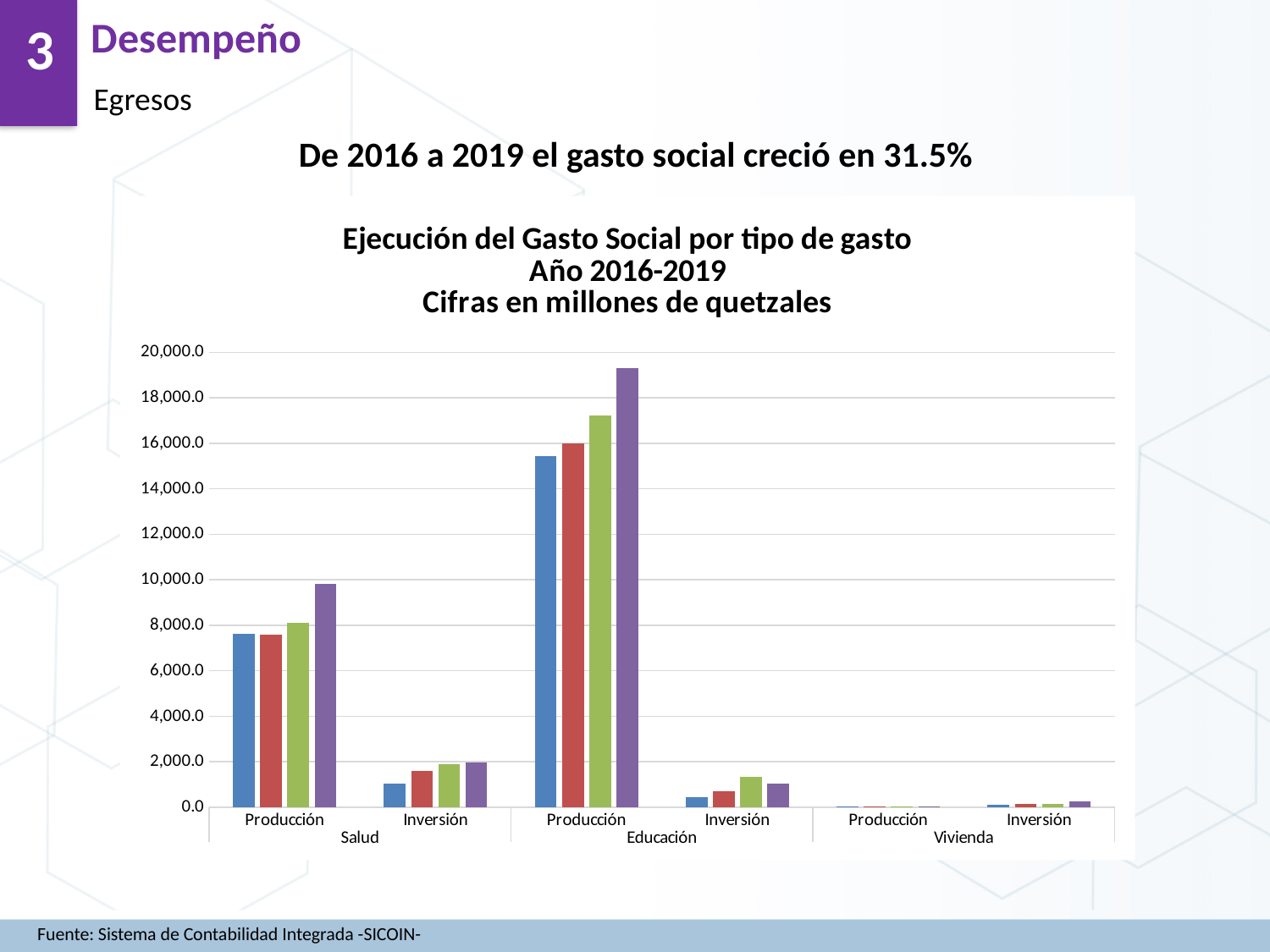
Are the bars for Vivienda Inversión greater or less than 2,000.0? less Which category has the lowest bars in the chart? Vivienda Producción How many bars are plotted for each category (e.g. Salud Producción)? 4 What kind of chart is shown on the slide? bar chart Within the Educación Producción group, do the bars rise or fall from left to right? rise What is the title of the chart? Ejecución del Gasto Social por tipo de gasto Año 2016-2019 Cifras en millones de quetzales Is the tallest bar for Educación Producción greater or less than 18,000.0? greater Is the tallest bar for Salud Producción greater or less than 8,000.0? greater Which has larger values, Salud Producción or Educación Producción? Educación Producción Which category has the tallest bars in the chart? Educación Producción How many sectors (top-level category groups) are shown on the x axis? 3